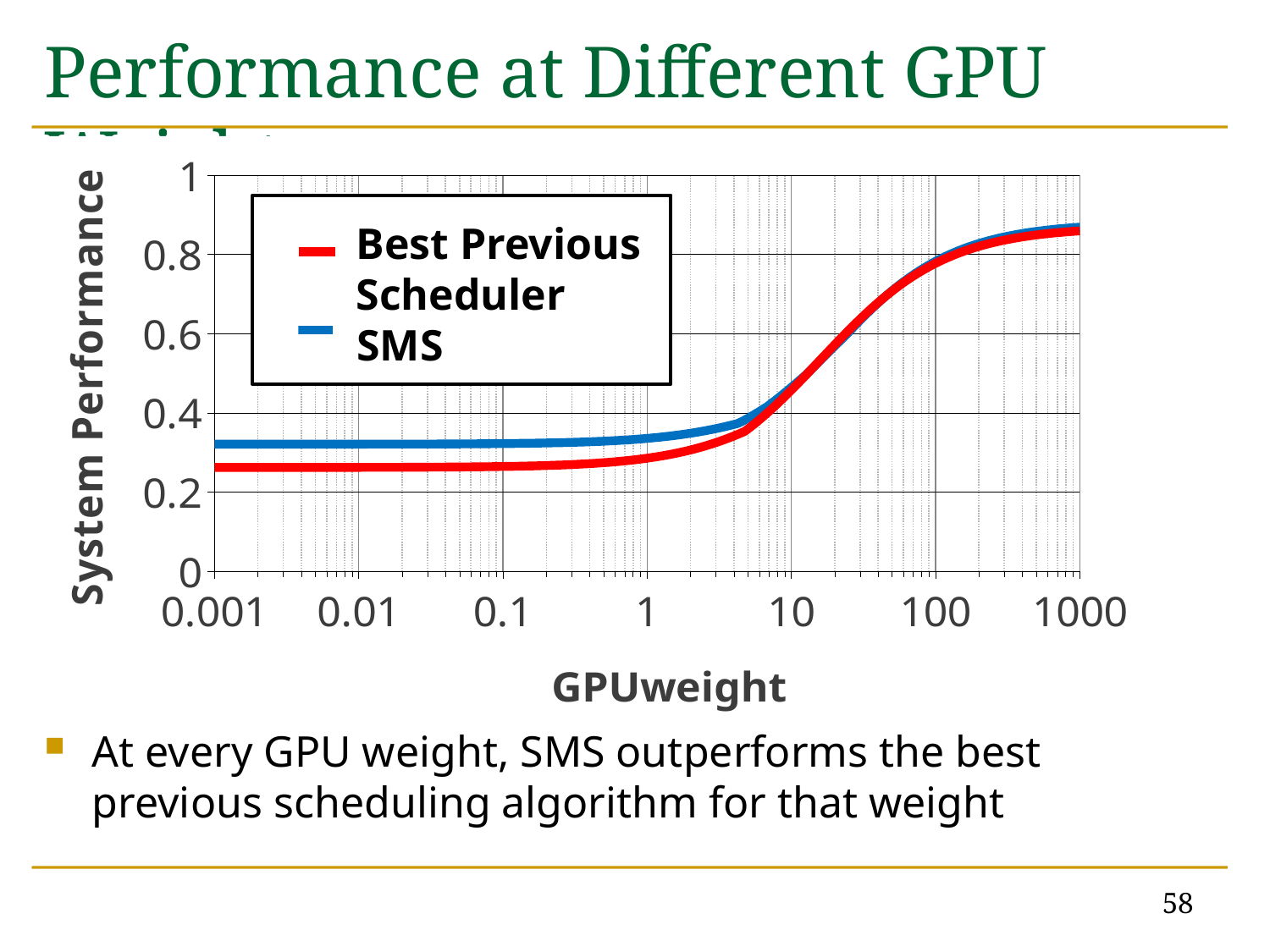
Is the System Performance of SMS at a GPUweight of 1000 greater or less than 0.8? greater Do the System Performance values rise or fall as GPUweight increases from 0.001 to 1000? rise What are the two series named in the legend? Best Previous Scheduler and SMS Is the System Performance of SMS at a GPUweight of 0.001 greater or less than 0.4? less At a GPUweight of 1, which series has the higher System Performance, SMS or Best Previous Scheduler? SMS How many labeled tick values are shown on the GPUweight axis? 7 How many series does the legend list? 2 At a GPUweight of 0.01, which series has the higher System Performance, SMS or Best Previous Scheduler? SMS What kind of chart is shown on the slide? line chart Is the System Performance of the Best Previous Scheduler at a GPUweight of 0.1 greater or less than 0.4? less What is the label of the x axis? GPUweight